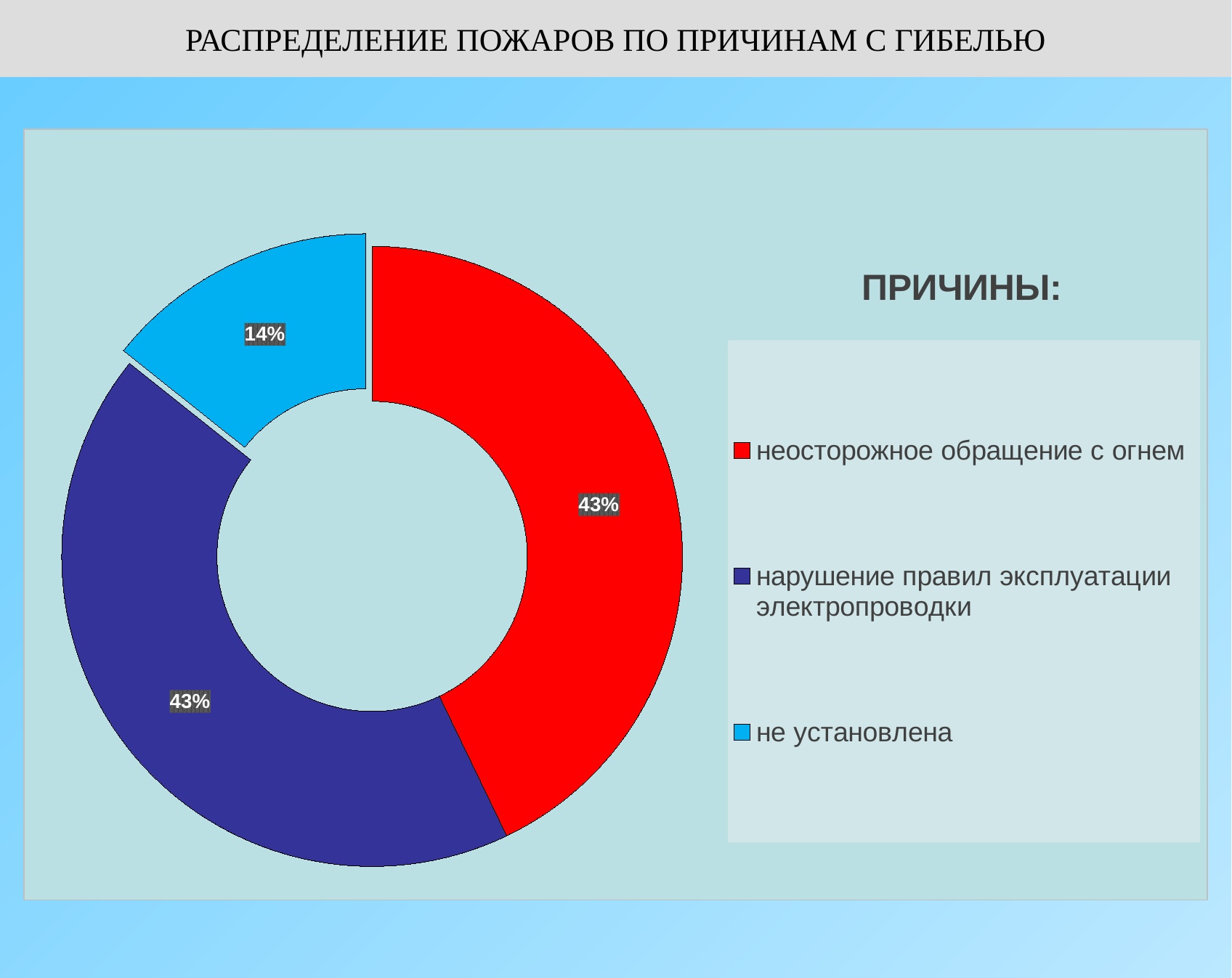
What is the title of the slide? РАСПРЕДЕЛЕНИЕ ПОЖАРОВ ПО ПРИЧИНАМ С ГИБЕЛЬЮ What kind of chart is shown on the slide? Doughnut (pie) chart Is the share for "не установлена" greater or less than 20%? less Which is larger: the share for "неосторожное обращение с огнем" or the share for "не установлена"? неосторожное обращение с огнем Which cause has the smallest share of fires? не установлена Which colour represents "не установлена" in the chart? Light blue What share of fires is attributed to "неосторожное обращение с огнем"? 43% What share of fires is attributed to "нарушение правил эксплуатации электропроводки"? 43% How many causes (slices) are shown in the chart? 3 Do the two largest slices, "неосторожное обращение с огнем" and "нарушение правил эксплуатации электропроводки", have the same share? Yes, 43% each What share of fires has the cause "не установлена"? 14% By how many percentage points does the share for "нарушение правил эксплуатации электропроводки" exceed the share for "не установлена"? 29 percentage points